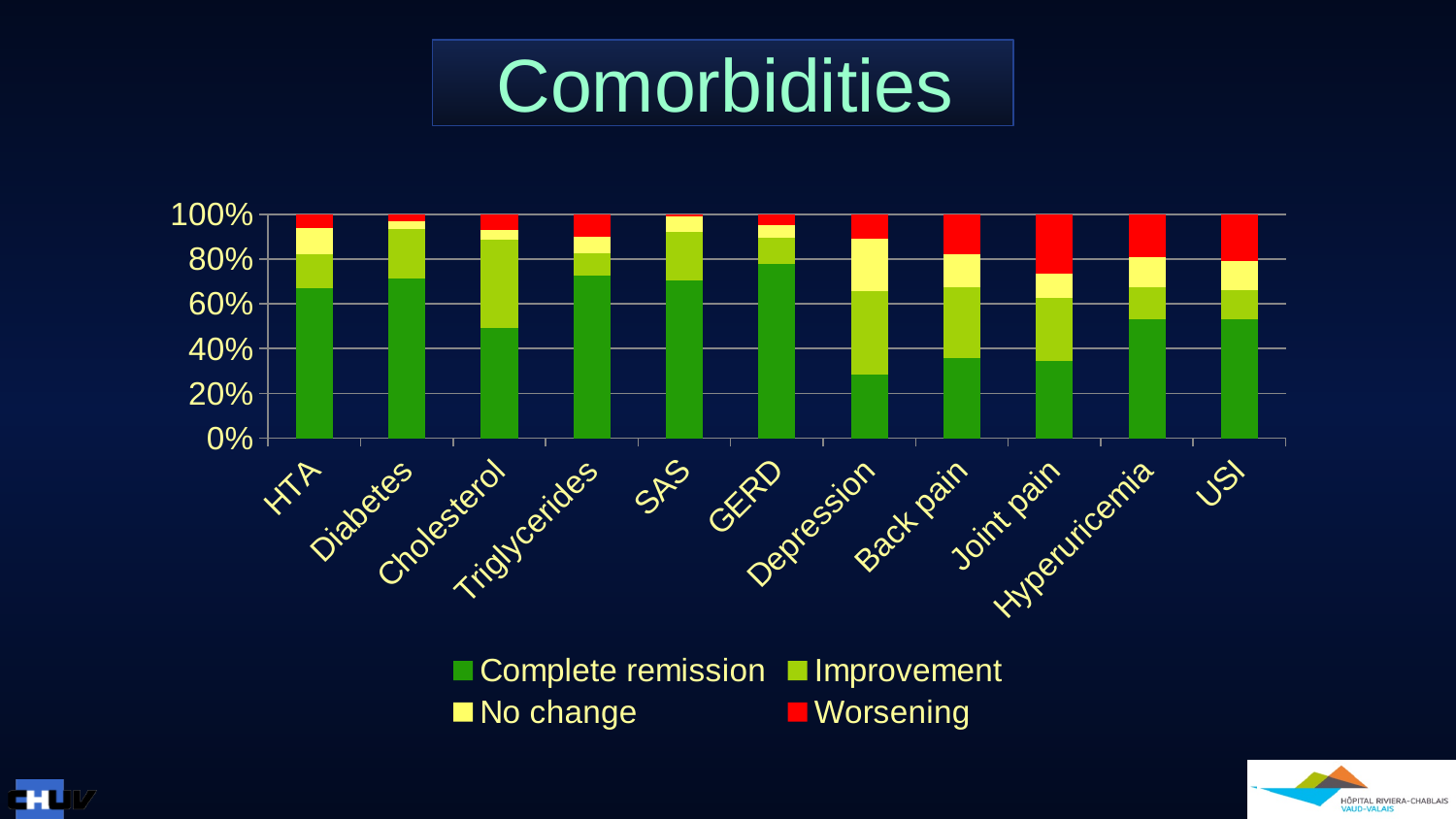
Is the Complete remission share for Depression greater or less than 40%? less What is the total height of the stacked bar for HTA? 100% Which category has the largest Worsening share? Joint pain Is the Complete remission share for GERD greater or less than 60%? greater Which has the larger Complete remission share, Cholesterol or Triglycerides? Triglycerides What kind of chart is shown on the slide? Stacked bar chart How many comorbidity categories are shown on the x axis? 11 Which category has the smallest Complete remission share? Depression How many series does the legend list? 4 What is the title of the chart? Comorbidities Which category has the smallest Worsening share? SAS Which colour represents the Worsening series in the legend? Red